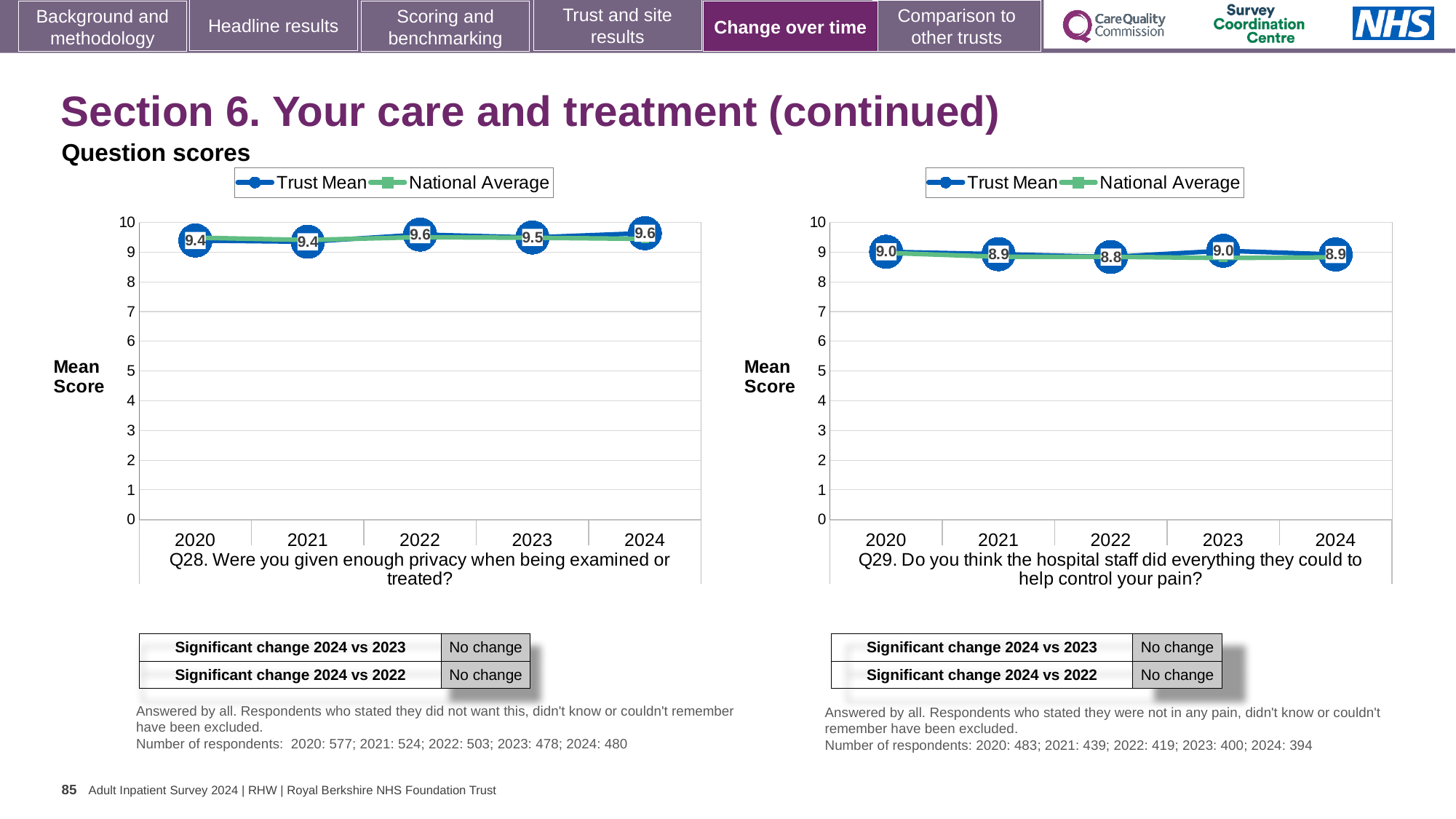
How many years are plotted on the x axis of the Q28 chart on the left? 5 In the Q28 chart on the left, what is the Trust Mean score for 2024? 9.6 In the Q28 chart on the left, which year has the higher Trust Mean score, 2021 or 2022? 2022 What kind of chart is the Q28 chart on the left? Line chart In the Q29 chart on the right, what is the Trust Mean score for 2022? 8.8 In the Q28 chart on the left, what is the Trust Mean score for 2020? 9.4 In the Q28 chart on the left, what is the difference between the Trust Mean scores for 2024 and 2020? 0.2 In the Q29 chart on the right, is the National Average value for 2024 greater or less than 8? greater What question text is shown beneath the x axis of the chart on the right? Q29. Do you think the hospital staff did everything they could to help control your pain? In the Q29 chart on the right, which year has the lowest Trust Mean score? 2022 In the Q29 chart on the right, what is the Trust Mean score for 2023? 9.0 How many series does the legend of the Q29 chart on the right list? 2